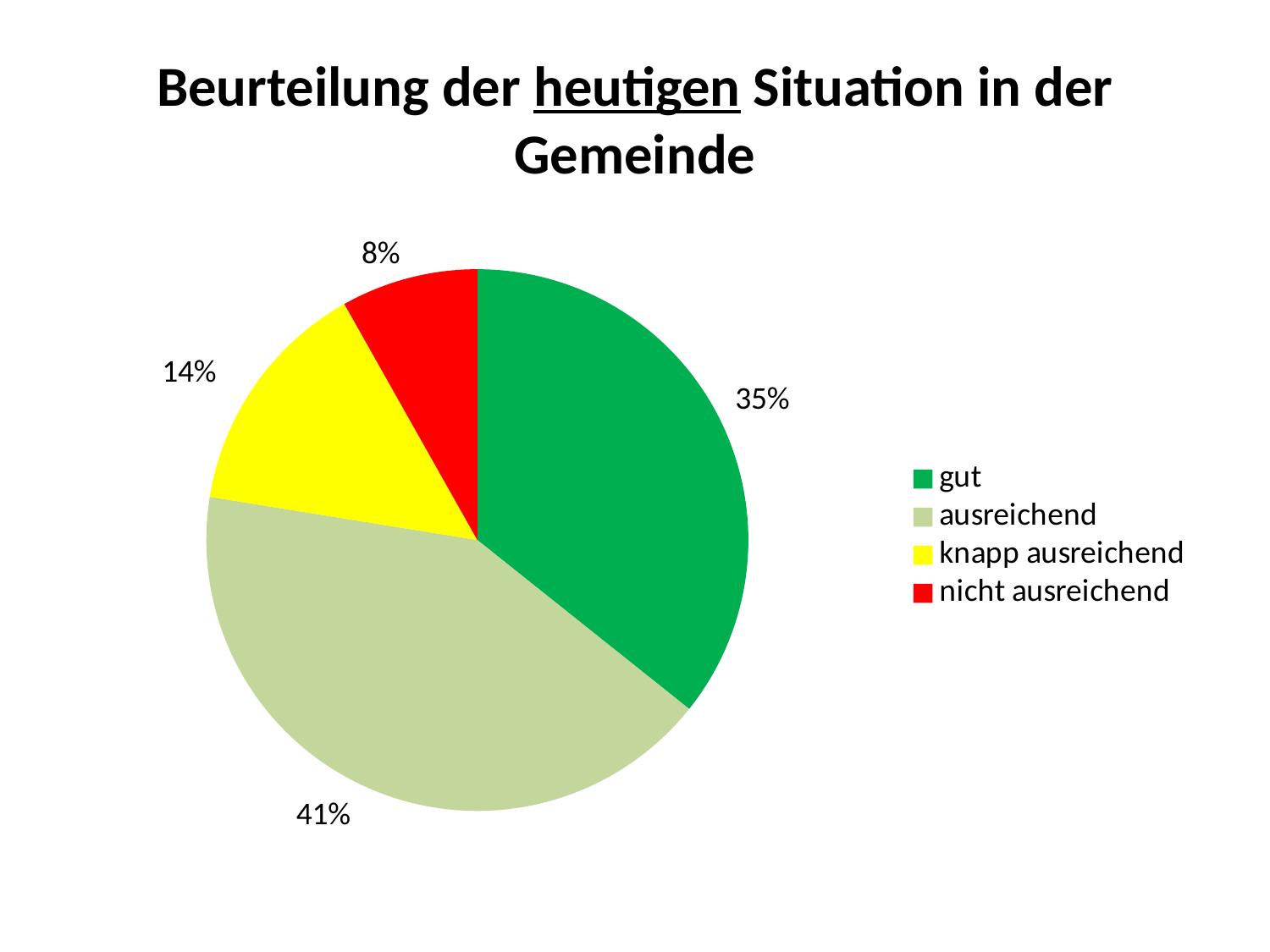
What share of the pie does "gut" represent? 35% What share of the pie does "ausreichend" represent? 41% How many categories does the pie chart show? 4 What is the difference in percentage points between "knapp ausreichend" and "nicht ausreichend"? 6 Which category has the smallest slice of the pie? nicht ausreichend Which is larger, the slice for "gut" or the slice for "knapp ausreichend"? gut What kind of chart is shown on the slide? pie chart What colour is the slice for "nicht ausreichend"? red Which category has the largest slice of the pie? ausreichend What share of the pie does "knapp ausreichend" represent? 14% What is the difference in percentage points between "ausreichend" and "gut"? 6